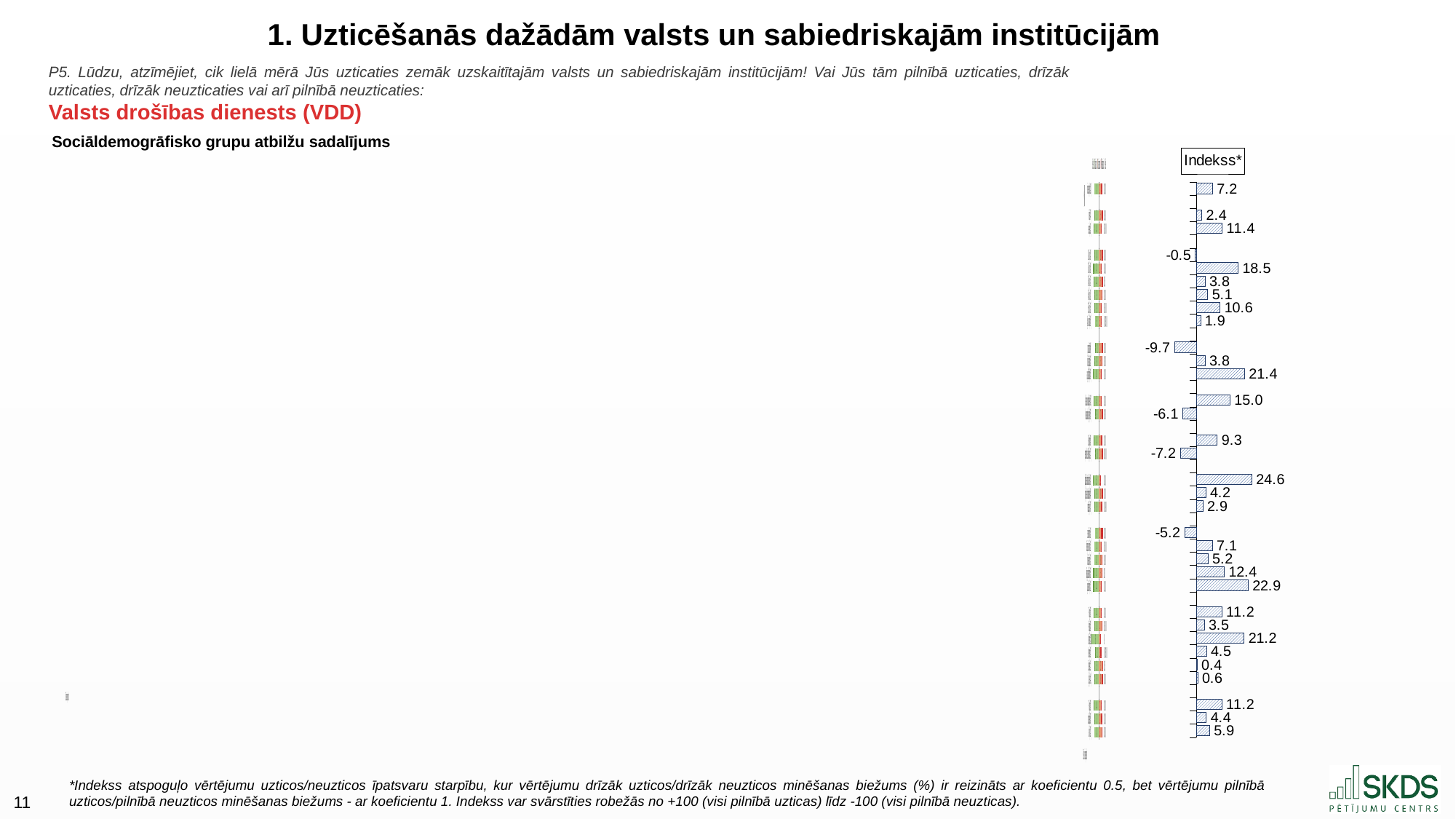
What type of chart is the "Indekss*" chart on the right of the slide? bar chart In the "Indekss*" chart, how many bars have a value greater than 20? 4 In the "Indekss*" chart, what is the value of the bottom-most bar? 5.9 In the "Indekss*" chart, what is the difference between the highest value (24.6) and the lowest value (-9.7)? 34.3 In the "Indekss*" chart, how many bars are plotted in total? 33 In the "Indekss*" chart, is the topmost bar's value greater or less than 0? greater In the "Indekss*" chart, which is larger: the value 22.9 or the value 21.4? 22.9 In the "Indekss*" chart, how many bars have a negative value? 5 What is the title shown above the index chart on the right side of the slide? Indekss* In the "Indekss*" chart, what is the highest value shown? 24.6 In the "Indekss*" chart, what is the lowest value shown? -9.7 In the "Indekss*" chart, what is the value of the topmost bar? 7.2